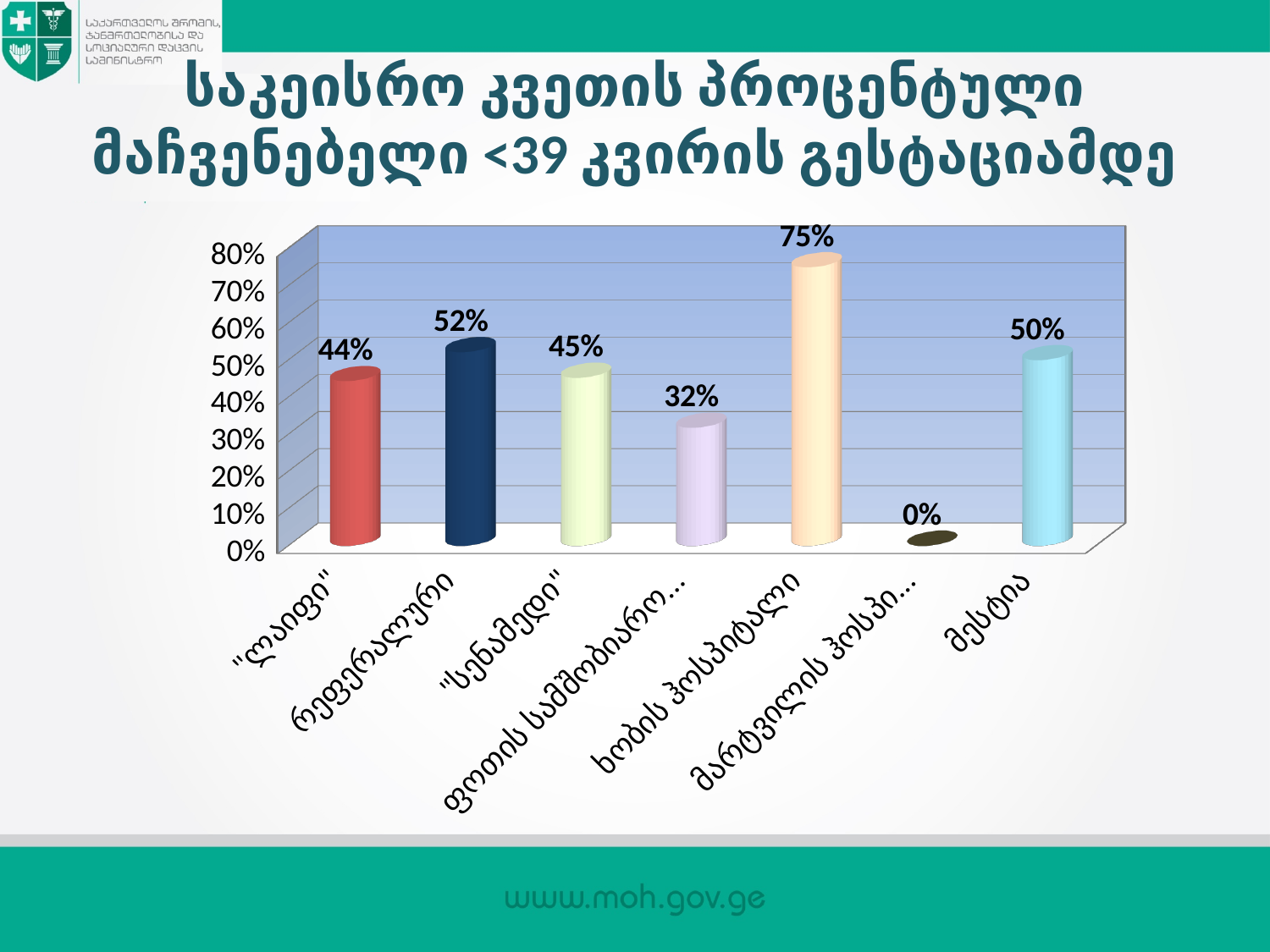
Which category has the lowest value? მარტვილის ჰოსპი... What is the value for რეფერალური? 52% What is the value for მესტია? 50% Is the value for მესტია greater or less than 40%? greater What is the difference between the values for ხობის ჰოსპიტალი and "ლაიფი"? 31% What kind of chart is shown on the slide? bar chart Which is larger, the value for რეფერალური or the value for "სენამედი"? რეფერალური Which category has the highest value? ხობის ჰოსპიტალი What is the value for "ლაიფი"? 44% What is the value for ხობის ჰოსპიტალი? 75% How many categories are shown on the chart? 7 What is the title of the chart on the slide? საკეისრო კვეთის პროცენტული მაჩვენებელი <39 კვირის გესტაციამდე